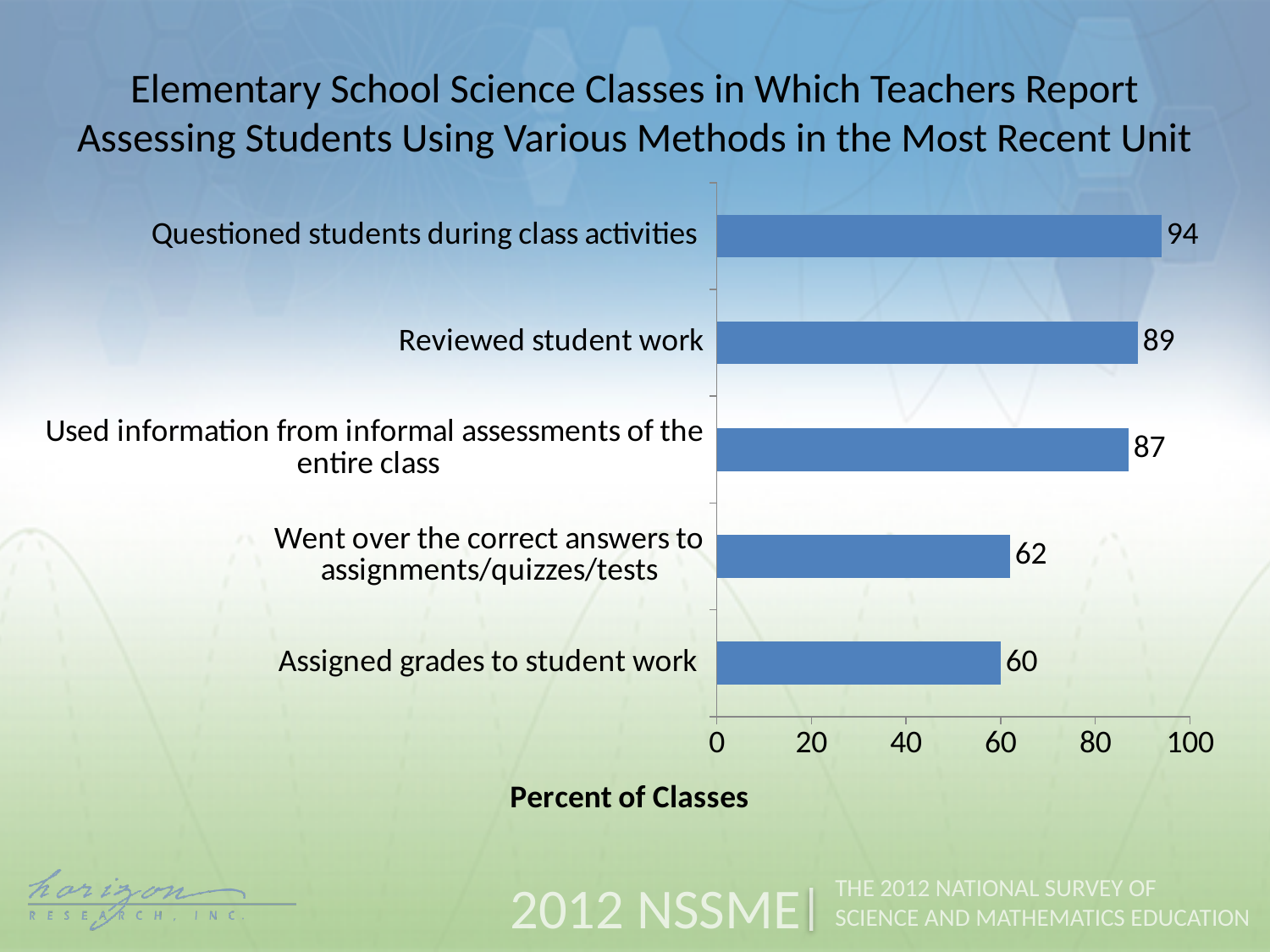
What is the value for 'Assigned grades to student work'? 60 Which assessment method has the lowest percent of classes? Assigned grades to student work What is the maximum value shown on the horizontal axis? 100 Is the value for 'Went over the correct answers to assignments/quizzes/tests' greater or less than 80? less Which assessment method has the highest percent of classes? Questioned students during class activities Which is larger: 'Reviewed student work' or 'Used information from informal assessments of the entire class'? Reviewed student work What percent of classes reported 'Questioned students during class activities'? 94 What kind of chart is shown on the slide? bar chart What is the label of the horizontal axis? Percent of Classes What is the difference between 'Reviewed student work' and 'Went over the correct answers to assignments/quizzes/tests'? 27 What is the value for 'Used information from informal assessments of the entire class'? 87 How many assessment methods are shown in the chart? 5